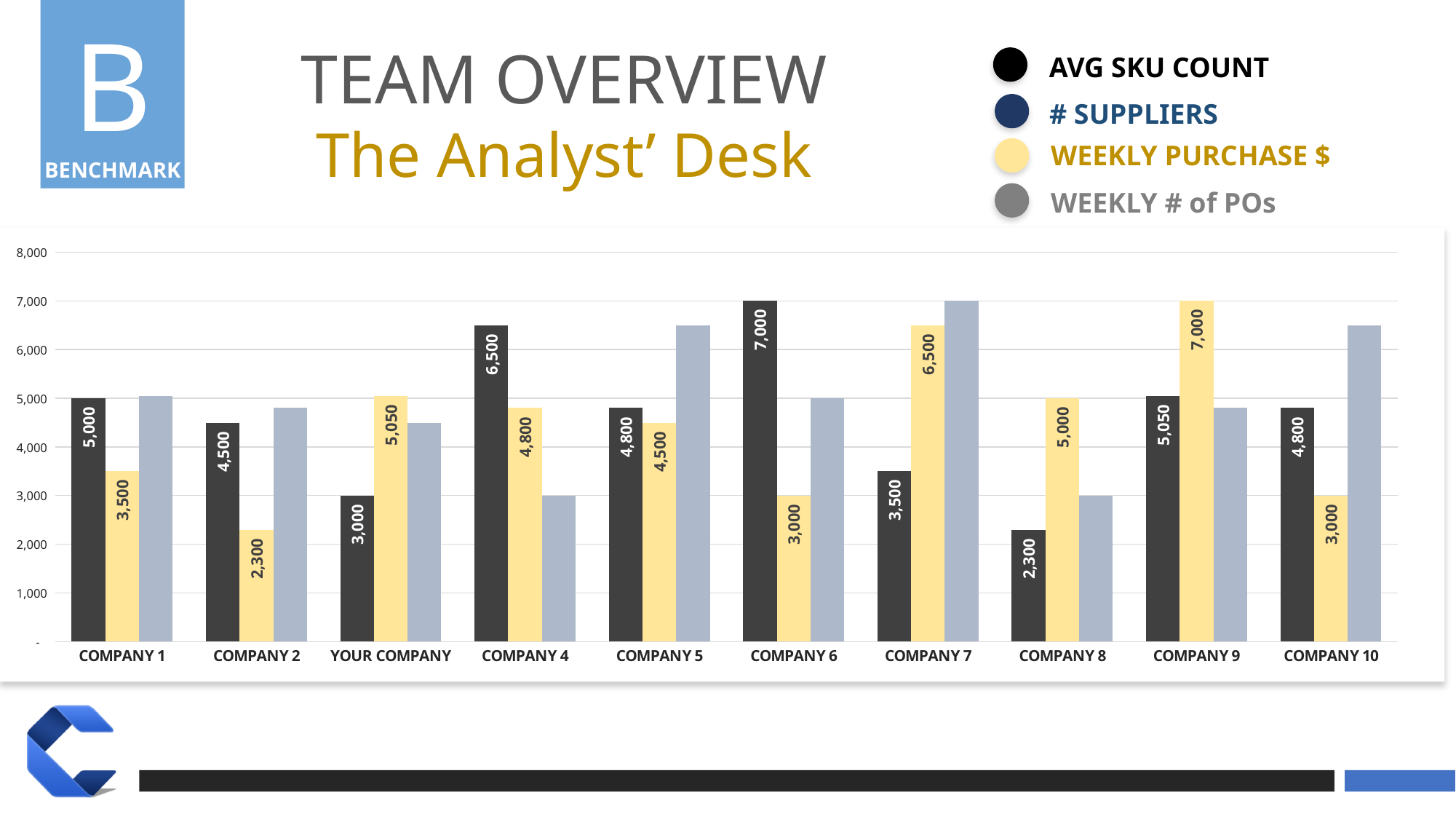
What is the AVG SKU COUNT value for Company 6? 7,000 How many series does the legend list? 4 What is the WEEKLY PURCHASE $ value for Your Company? 5,050 What is the AVG SKU COUNT value for Company 8? 2,300 Which is larger for Company 2: the AVG SKU COUNT or the WEEKLY PURCHASE $? AVG SKU COUNT Is the WEEKLY # of POs value for Company 10 greater or less than 6,000? greater What is the difference between the AVG SKU COUNT and the WEEKLY PURCHASE $ for Company 7? 3,000 What type of chart is shown on the slide? Bar chart Which company has the lowest AVG SKU COUNT value? Company 8 Which legend entry is shown in yellow? WEEKLY PURCHASE $ How many companies are shown along the x axis of the chart? 10 Which company has the highest WEEKLY PURCHASE $ value? Company 9